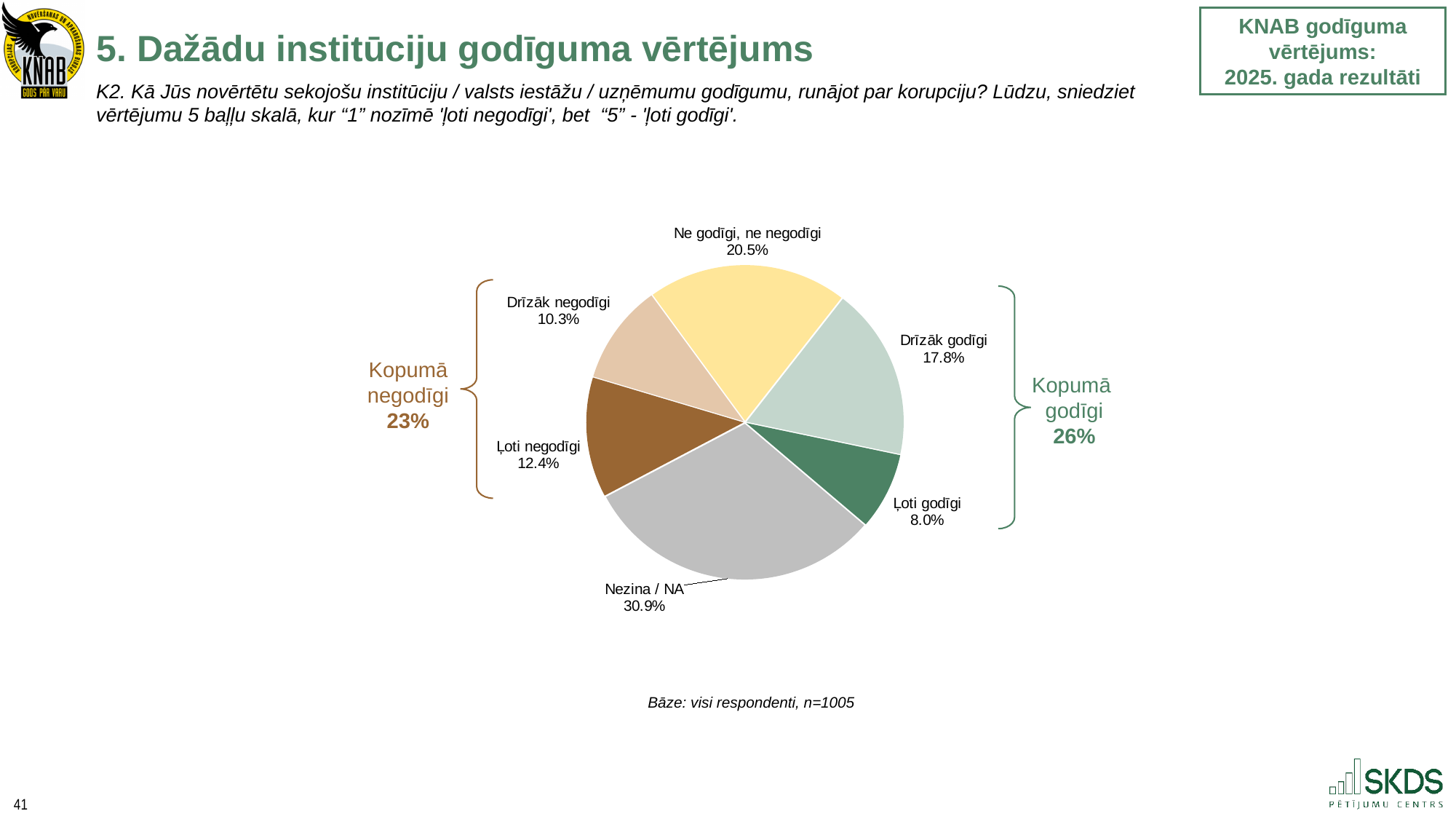
What is the value for "Ne godīgi, ne negodīgi"? 20.5% What combined percentage is shown for "Kopumā negodīgi"? 23% What is the difference between "Drīzāk godīgi" and "Drīzāk negodīgi"? 7.5% What is the value for "Drīzāk godīgi"? 17.8% What is the value for "Nezina / NA"? 30.9% Which is larger, "Ļoti negodīgi" or "Ļoti godīgi"? Ļoti negodīgi How many slices does the pie chart have? 6 What combined percentage is shown for "Kopumā godīgi"? 26% Which slice of the pie is the largest? Nezina / NA What kind of chart is shown on the slide? pie chart What is the value for "Ļoti negodīgi"? 12.4% Which slice of the pie is the smallest? Ļoti godīgi